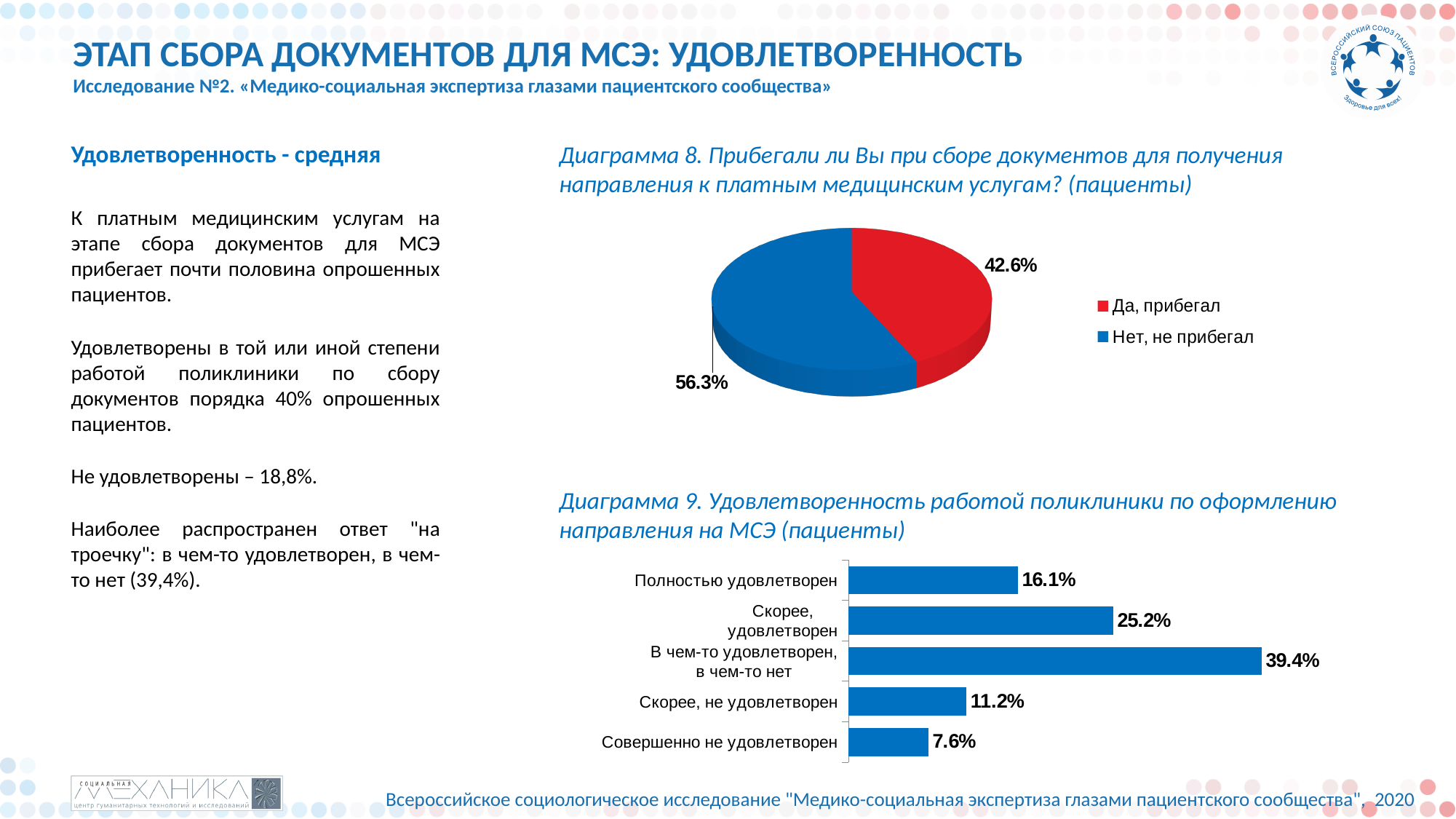
How many entries does the legend of Диаграмма 8 list? 2 In Диаграмма 8, what share of patients answered «Нет, не прибегал»? 56.3% In Диаграмма 9, what is the value for «В чем-то удовлетворен, в чем-то нет»? 39.4% What kind of chart is Диаграмма 8? Pie chart How many categories are shown in Диаграмма 9? 5 In Диаграмма 9, which category has the highest value? В чем-то удовлетворен, в чем-то нет In Диаграмма 8, what share of patients answered «Да, прибегал»? 42.6% In Диаграмма 8, which answer has the larger share: «Да, прибегал» or «Нет, не прибегал»? Нет, не прибегал In Диаграмма 9, what is the difference in percentage points between «Скорее, удовлетворен» and «Полностью удовлетворен»? 9.1 In Диаграмма 8, what is the difference in percentage points between «Нет, не прибегал» and «Да, прибегал»? 13.7 In Диаграмма 9, which category has the lowest value? Совершенно не удовлетворен In Диаграмма 9, what is the value for «Совершенно не удовлетворен»? 7.6%